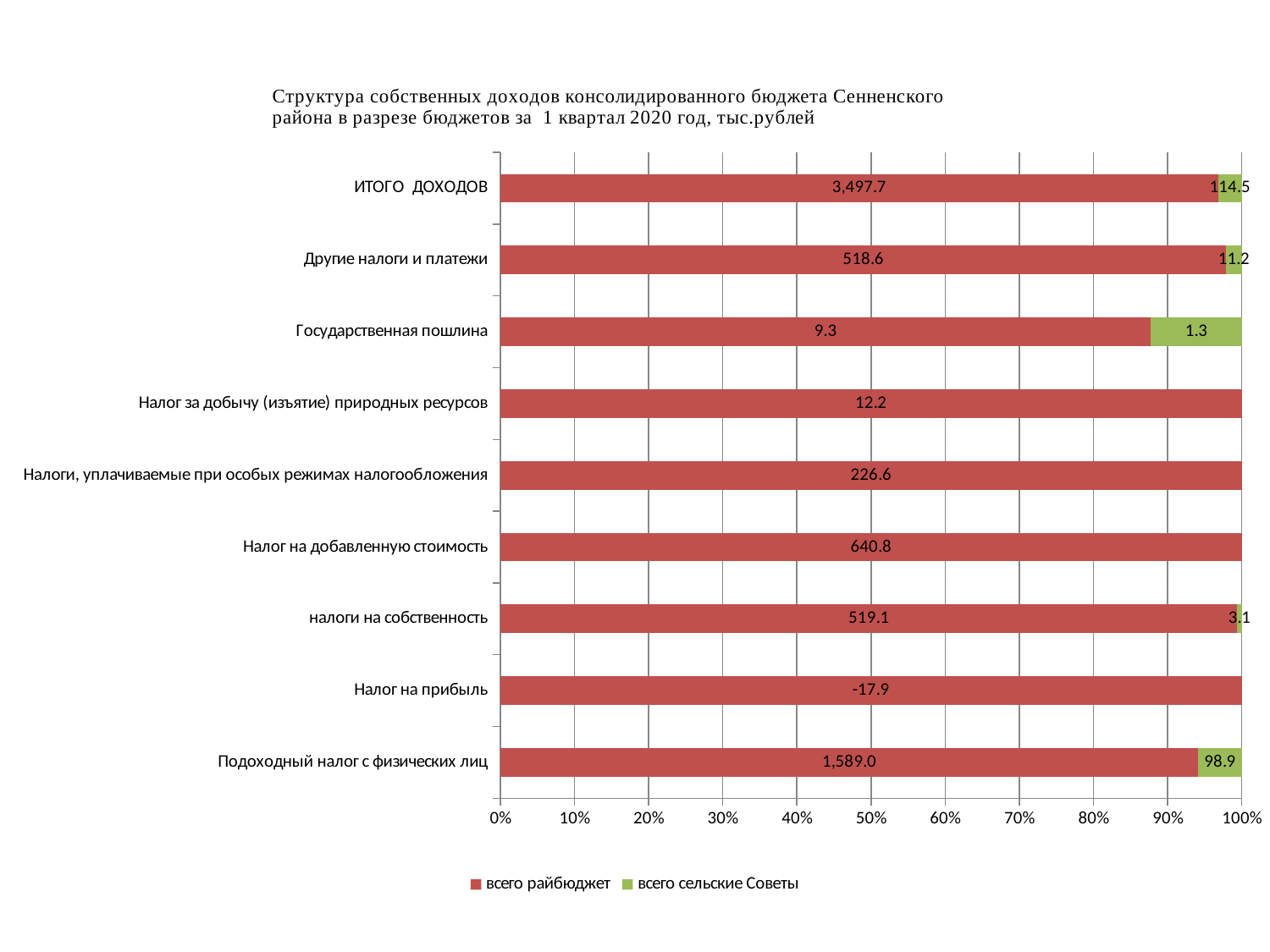
Which category has the lowest value for всего райбюджет? Налог на прибыль What is the value of всего райбюджет for Налог на прибыль? -17.9 Which category has the highest value for всего райбюджет? ИТОГО ДОХОДОВ What is the value of всего райбюджет for Подоходный налог с физических лиц? 1,589.0 What kind of chart is shown on the slide? Stacked bar chart What is the difference between the всего райбюджет values for Налог на добавленную стоимость and налоги на собственность? 121.7 What is the value of всего сельские Советы for Государственная пошлина? 1.3 How many categories are shown on the chart? 9 What is the value of всего сельские Советы for ИТОГО ДОХОДОВ? 114.5 Which is larger for всего сельские Советы: Подоходный налог с физических лиц or Другие налоги и платежи? Подоходный налог с физических лиц How many series does the legend list? 2 What is the total of the two series for Подоходный налог с физических лиц? 1,687.9